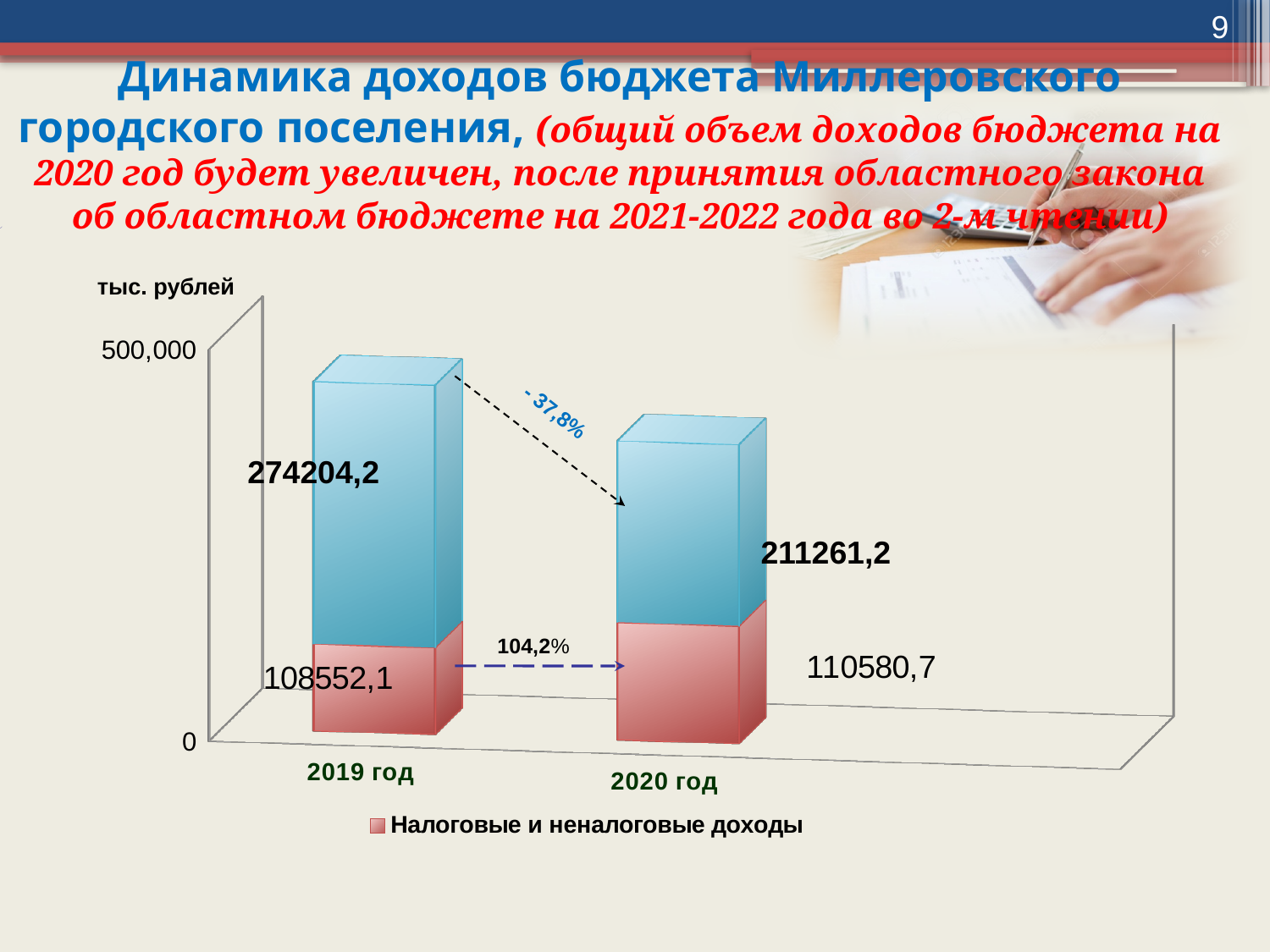
How many categories (years) are shown on the x axis of the chart? 2 What is the total of the stacked bar for 2019 год? 382756,3 What percentage label is shown on the dashed arrow between the upper blue segments of the two bars? - 37,8% What is the total of the stacked bar for 2020 год? 321841,9 Which year has the larger value for Налоговые и неналоговые доходы, 2019 год or 2020 год? 2020 год How many series does the chart legend list? 1 What is the value of the upper blue segment for 2020 год? 211261,2 What is the value of the Налоговые и неналоговые доходы segment for 2019 год? 108552,1 What is the value of the upper blue segment for 2019 год? 274204,2 What kind of chart is shown on the slide? Stacked bar chart What is the value of the Налоговые и неналоговые доходы segment for 2020 год? 110580,7 What is the difference between the upper blue segment values for 2019 год and 2020 год? 62943,0